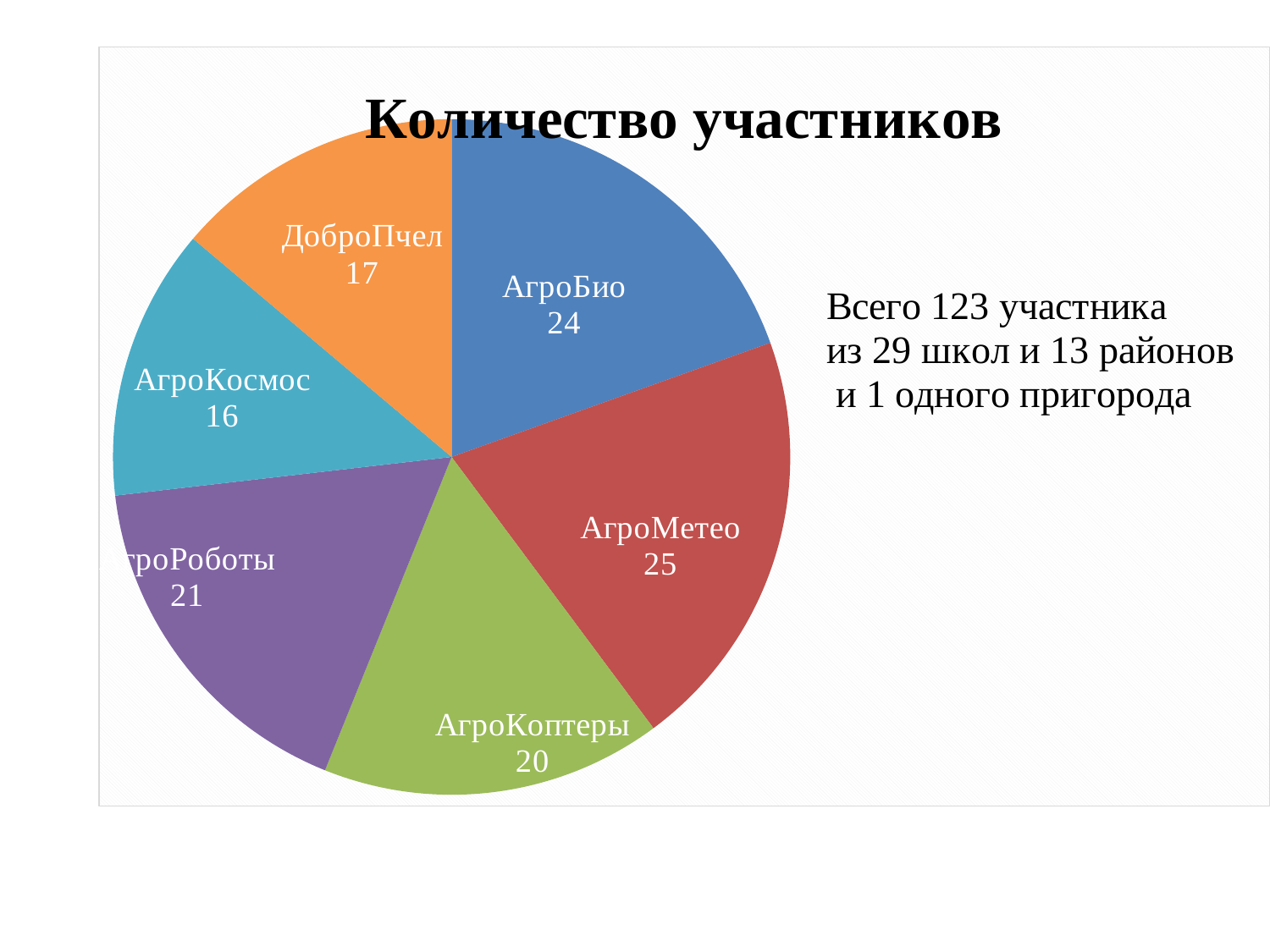
Which category has the lowest value? АгроКосмос Which is larger, АгроРоботы or ДоброПчел? АгроРоботы What is the value for АгроКосмос? 16 What colour is the АгроМетео slice? Red What is the total of all slices in the pie chart? 123 What is the value for АгроКоптеры? 20 Which category has the highest value? АгроМетео What is the title of the chart? Количество участников What type of chart is shown on the slide? Pie chart What is the difference between the values for АгроМетео and АгроКосмос? 9 How many slices does the pie chart have? 6 What is the value for АгроБио? 24